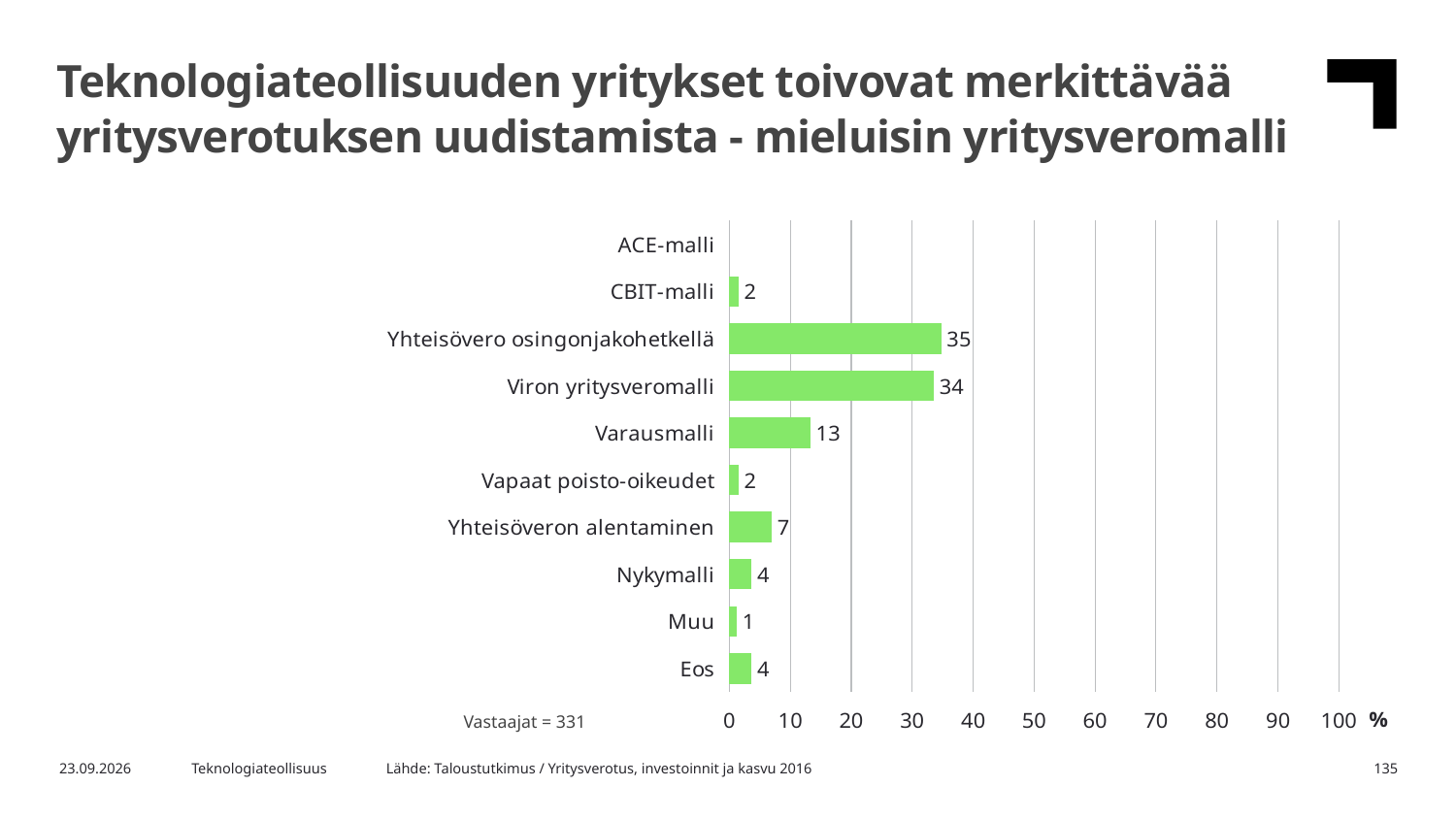
What is the difference between the values for Varausmalli and Yhteisöveron alentaminen? 6 Which category has the highest value? Yhteisövero osingonjakohetkellä Which is larger, the value for Nykymalli or the value for Yhteisöveron alentaminen? Yhteisöveron alentaminen What is the value for Yhteisövero osingonjakohetkellä? 35 What is the value for Varausmalli? 13 What type of chart is shown on the slide? bar chart What is the value for Yhteisöveron alentaminen? 7 Which category has no visible bar on the chart? ACE-malli What is the value for Muu? 1 How many categories are shown on the chart? 10 What is the value for Viron yritysveromalli? 34 What is the difference between the values for Yhteisövero osingonjakohetkellä and Viron yritysveromalli? 1